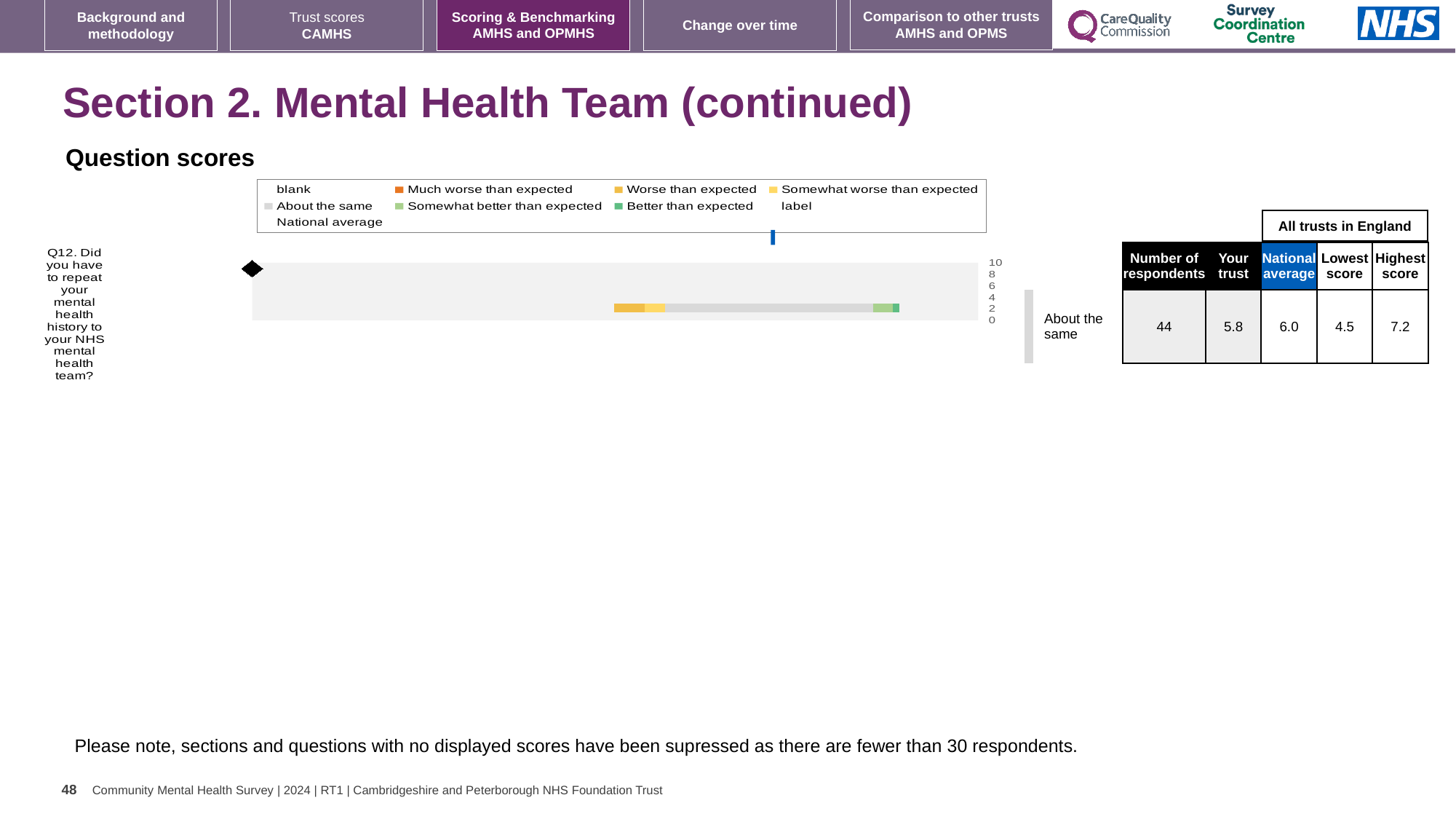
What is the difference between the highest and lowest scores among all trusts in England for Q12? 2.7 What is the number of respondents for Q12? 44 Which question is plotted in the question scores chart? Q12. Did you have to repeat your mental health history to your NHS mental health team? What is the national average score for Q12? 6.0 What is the lowest score among all trusts in England for Q12? 4.5 What benchmark category is shown next to the bar for Q12? About the same What kind of chart is used to show the question scores for Q12? bar chart What colour represents 'Much worse than expected' in the chart legend? orange What is the highest score among all trusts in England for Q12? 7.2 How many survey questions are plotted in the question scores chart? 1 What is the 'Your trust' score for Q12? 5.8 Which is larger for Q12, the 'Your trust' score or the national average? national average